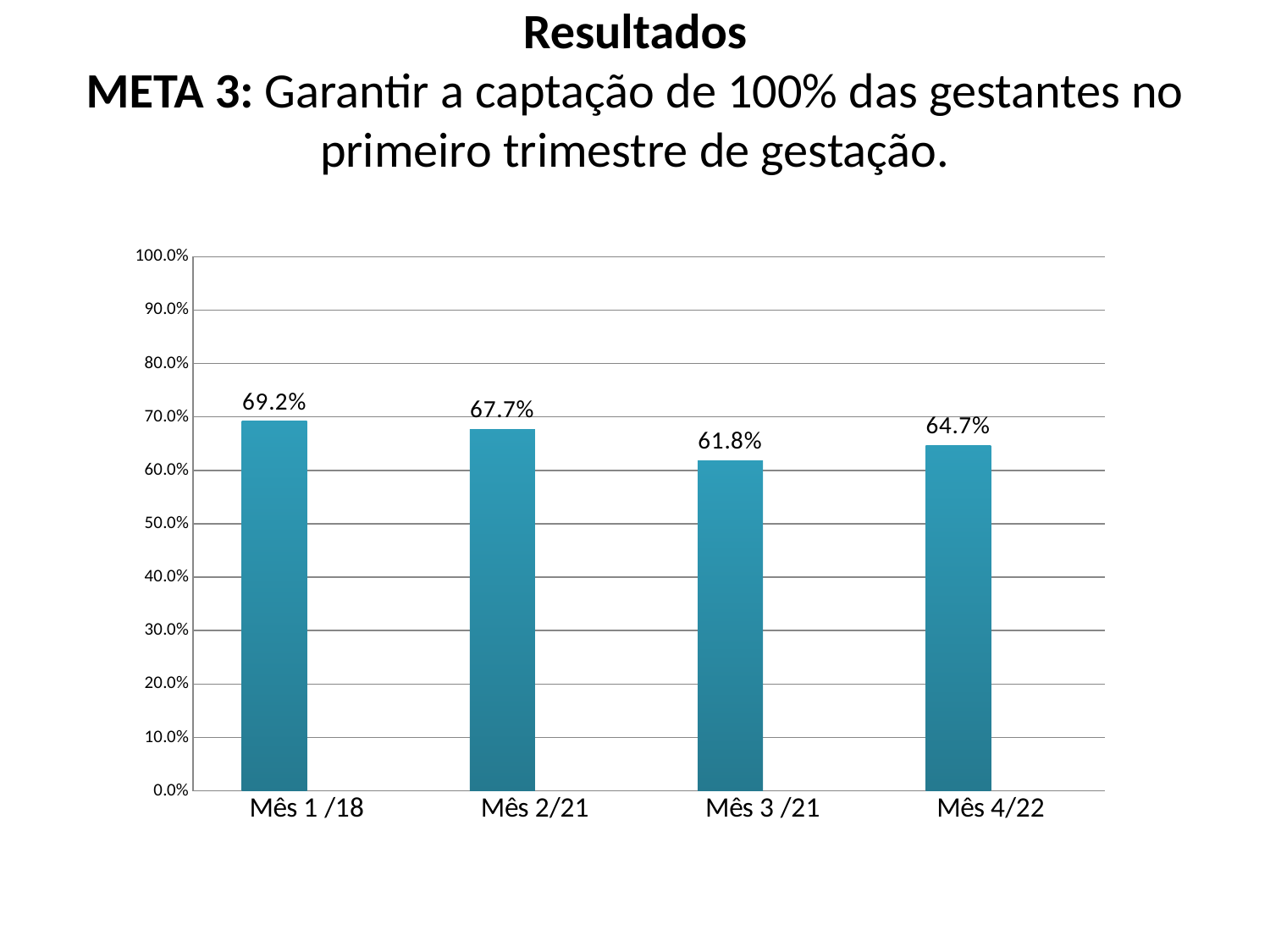
Is the value for Mês 3 /21 greater or less than 70.0%? less Which category has the lowest value? Mês 3 /21 Which category has the highest value? Mês 1 /18 What is the difference between the values for Mês 1 /18 and Mês 3 /21? 7.4% Which is larger, the value for Mês 2/21 or the value for Mês 4/22? Mês 2/21 How many categories are shown on the x axis? 4 What is the value for Mês 1 /18? 69.2% What is the maximum value shown on the y axis? 100.0% What is the value for Mês 4/22? 64.7% What is the difference between the values for Mês 2/21 and Mês 4/22? 3.0% What is the value for Mês 3 /21? 61.8% What kind of chart is shown on the slide? bar chart